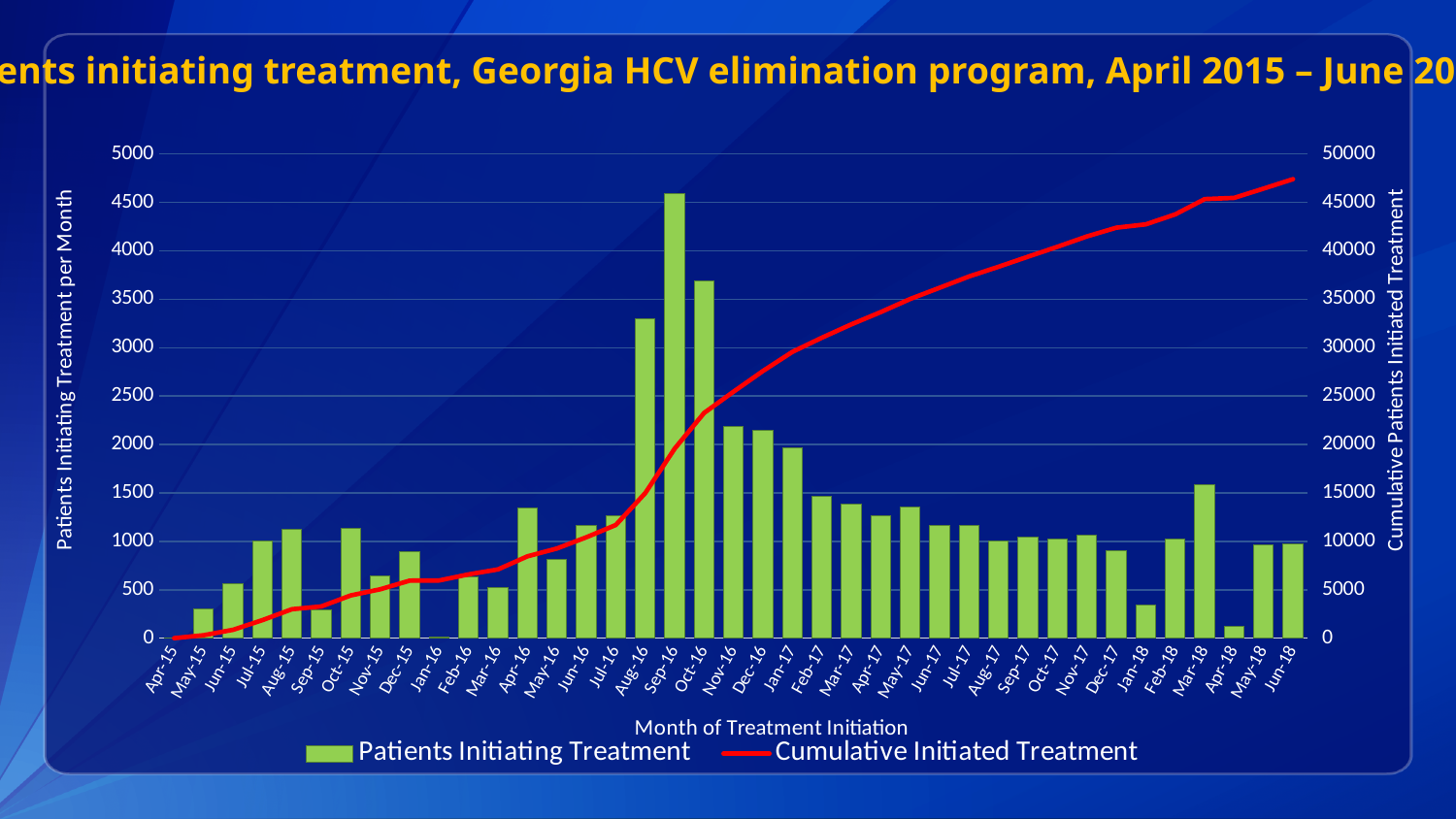
Which month had more patients initiating treatment, Mar-18 or Apr-18? Mar-18 Which month has the highest number of patients initiating treatment? Sep-16 How many months are shown along the x axis? 39 Which month had more patients initiating treatment, Aug-16 or Oct-16? Oct-16 Is the number of patients initiating treatment in Sep-16 greater or less than 4000? greater How many series does the legend list? 2 Is the number of patients initiating treatment in Apr-18 greater or less than 500? less Does the Cumulative Initiated Treatment line rise or fall from Apr-15 to Jun-18? rise What is the title of the left vertical axis? Patients Initiating Treatment per Month What are the two series named in the legend? Patients Initiating Treatment; Cumulative Initiated Treatment Is the cumulative initiated treatment value in Jun-18 greater or less than 45000? greater What kind of chart is shown on the slide? A combined bar and line chart